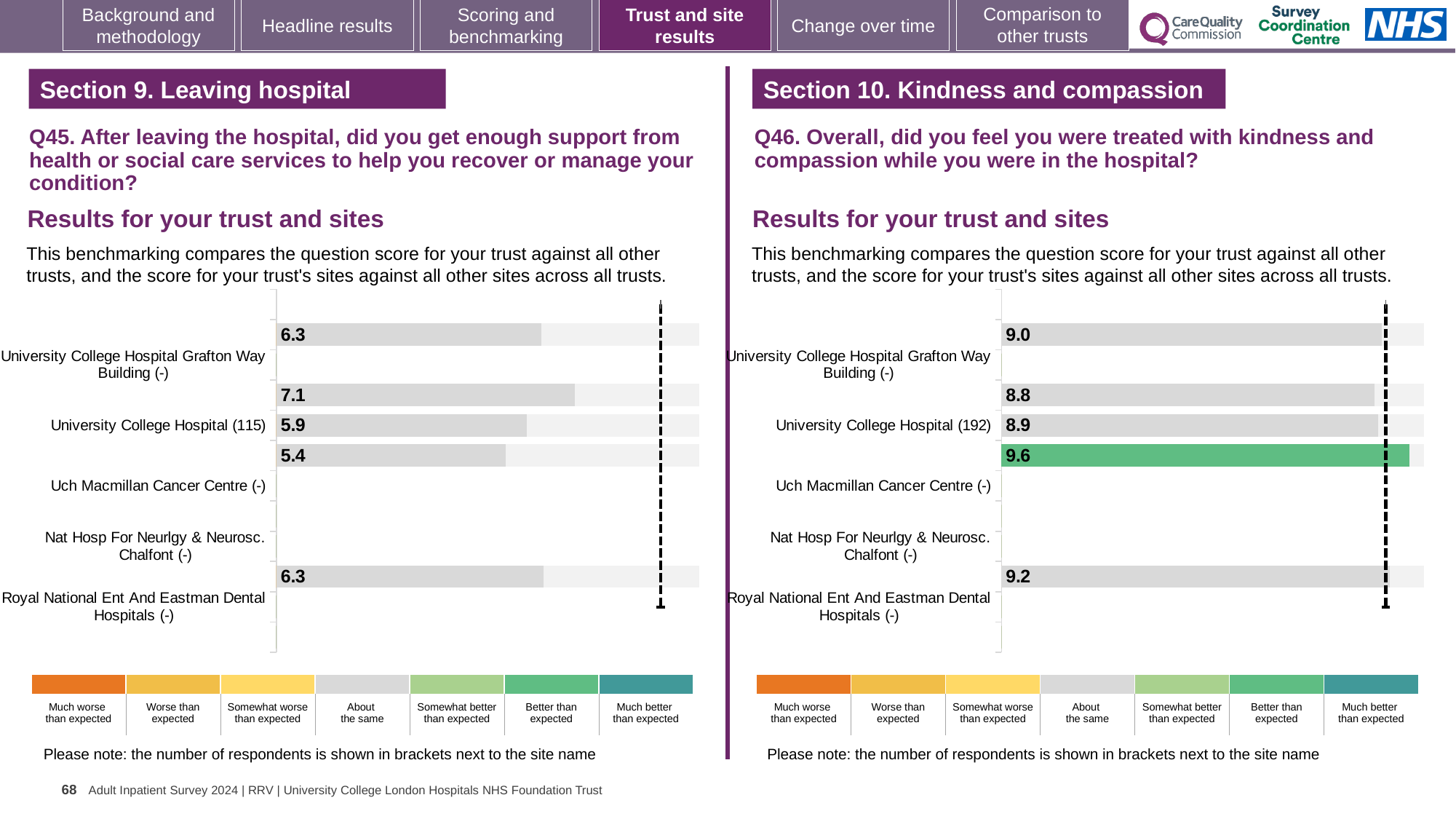
On the Q45 chart (left), what is the highest score printed on a bar? 7.1 On the Q46 chart (right), what is the lowest score printed on a bar? 8.8 On the Q45 chart (left), what is the difference between the highest printed score (7.1) and the lowest printed score (5.4)? 1.7 How many categories does the colour legend below each chart list? 7 On the Q45 chart (left), what is the lowest score printed on a bar? 5.4 Which is larger: the highest score on the Q46 chart (9.6) or the highest score on the Q45 chart (7.1)? Q46 chart (9.6) On the Q46 chart (right), which legend category does the green colour of the 9.6 bar correspond to? Better than expected On the Q46 chart (right), what is the difference between the highest printed score (9.6) and the lowest printed score (8.8)? 0.8 What kind of chart is used on the left (Q45) side of the slide? bar chart How many bars with printed scores are shown on the Q46 chart (right)? 5 On the Q46 chart (right), what is the highest score printed on a bar? 9.6 How many bars with printed scores are shown on the Q45 chart (left)? 5